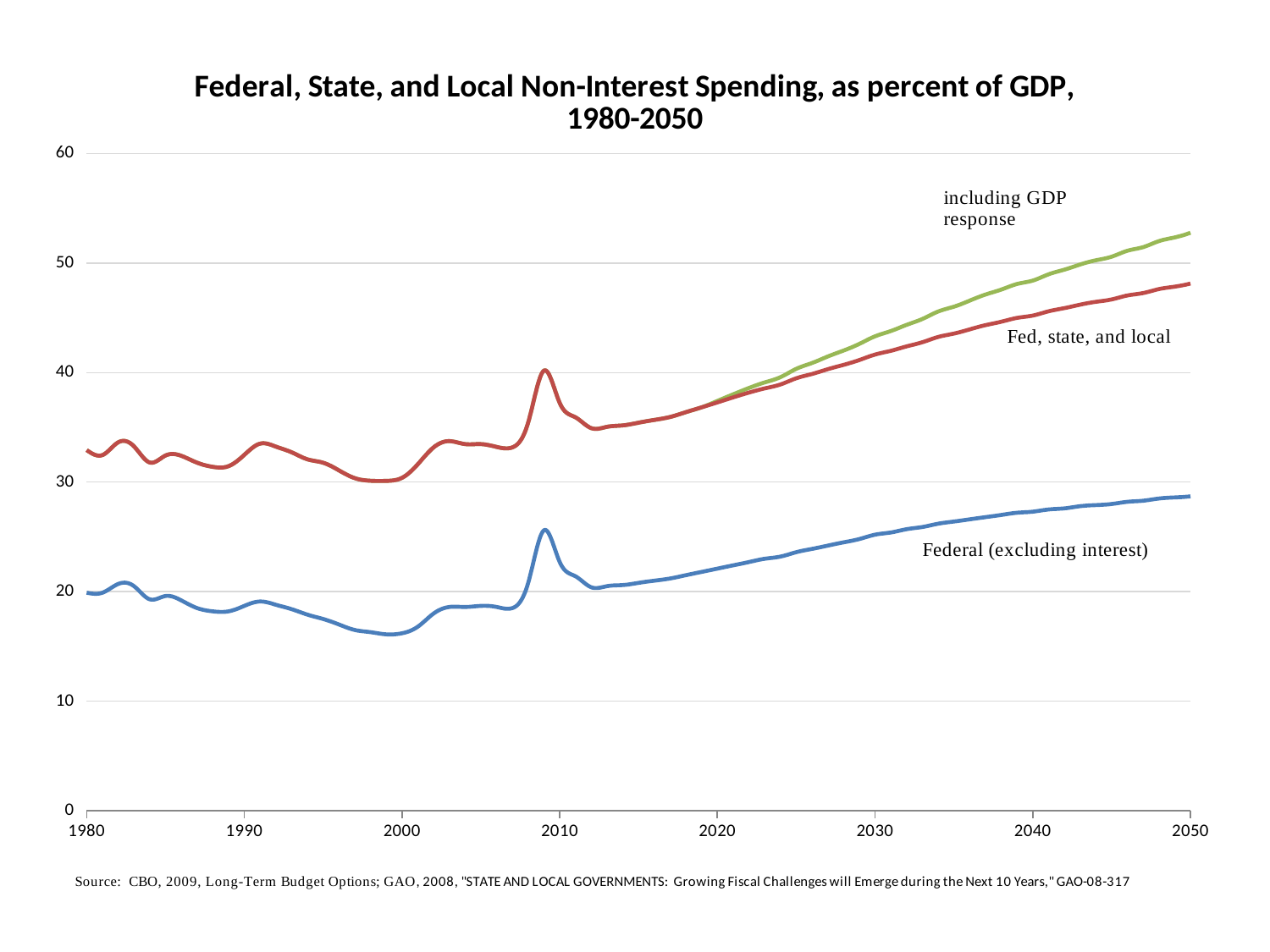
Is the value for Federal (excluding interest) in 2000 greater or less than 20? less Is the value for including GDP response in 2050 greater or less than 50? greater Is the value for Fed, state, and local in 2050 greater or less than 50? less What is the title of the chart? Federal, State, and Local Non-Interest Spending, as percent of GDP, 1980-2050 Does the Federal (excluding interest) series rise or fall between 2020 and 2050? rise Which series is drawn in green? including GDP response What kind of chart is shown on the slide? line chart In 2050, which series is higher: including GDP response or Fed, state, and local? including GDP response Which series is lowest across the whole period shown? Federal (excluding interest) How many data series are plotted on the chart? 3